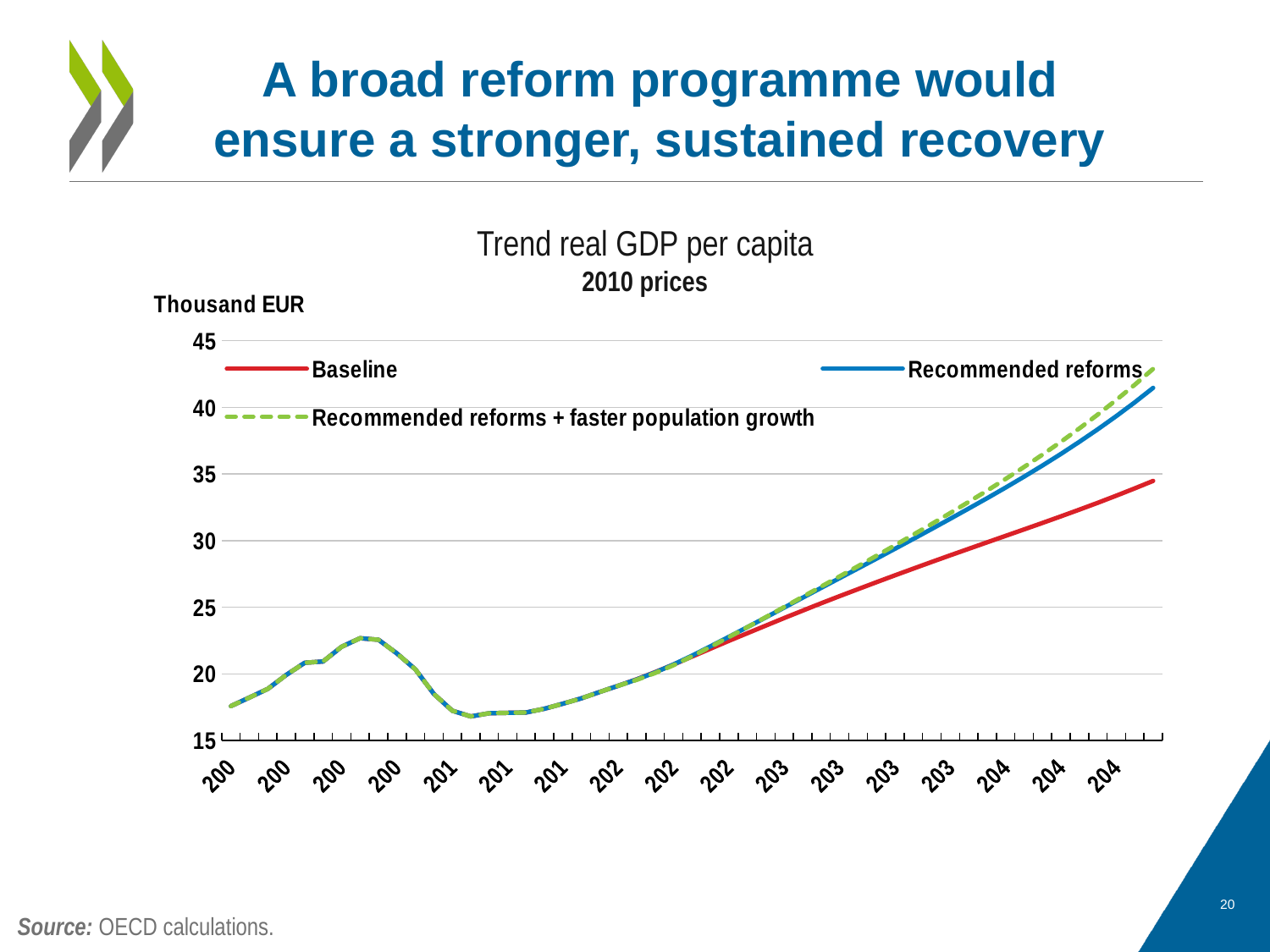
At the left end of the chart, are the series values greater or less than 20? less What unit is shown on the chart's vertical axis? Thousand EUR Which series ends at the lowest value at the right end of the chart? Baseline How many series does the chart's legend list? 3 At the right end of the chart, is the value for Recommended reforms greater or less than 40? greater Which series ends at the highest value at the right end of the chart? Recommended reforms + faster population growth At the right end of the chart, is the value for Recommended reforms + faster population growth greater or less than 40? greater What kind of chart is shown on the slide? line chart What is the title of the chart? Trend real GDP per capita Over the second half of the chart, do the values of the Baseline series rise or fall along the x axis? rise At the right end of the chart, which is larger: the Baseline value or the Recommended reforms value? Recommended reforms